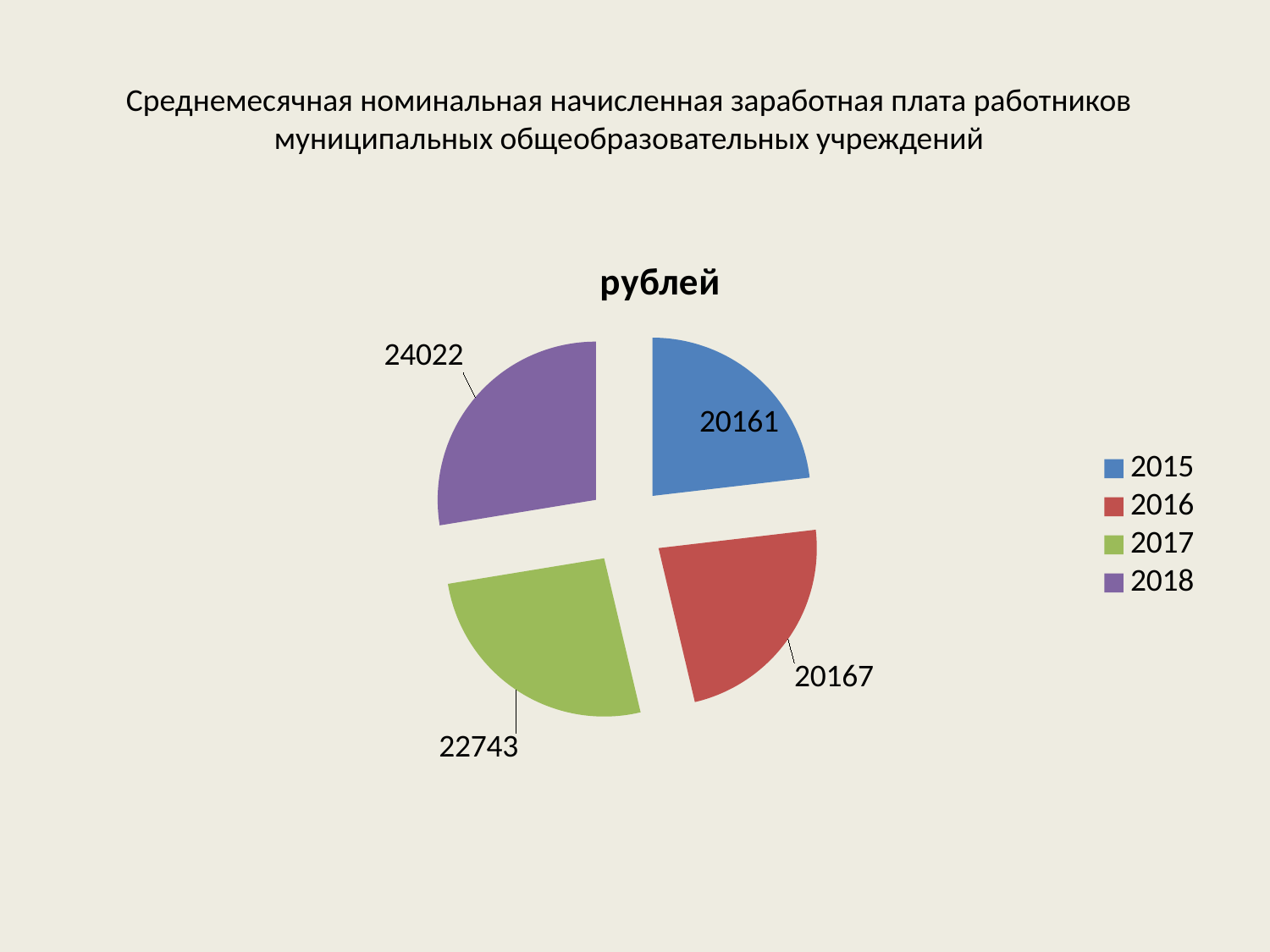
What is the value for 2018 in the pie chart? 24022 Which is larger, the value for 2017 or the value for 2018? 2018 Which year has the largest slice in the pie chart? 2018 What is the value for 2017 in the pie chart? 22743 What is the difference between the values for 2018 and 2017? 1279 What is the title of the pie chart? рублей What is the value for 2016 in the pie chart? 20167 What kind of chart is shown on the slide? Pie chart How many entries does the legend list? 4 How many slices does the pie chart have? 4 What is the value for 2015 in the pie chart? 20161 What is the difference between the values for 2017 and 2016? 2576